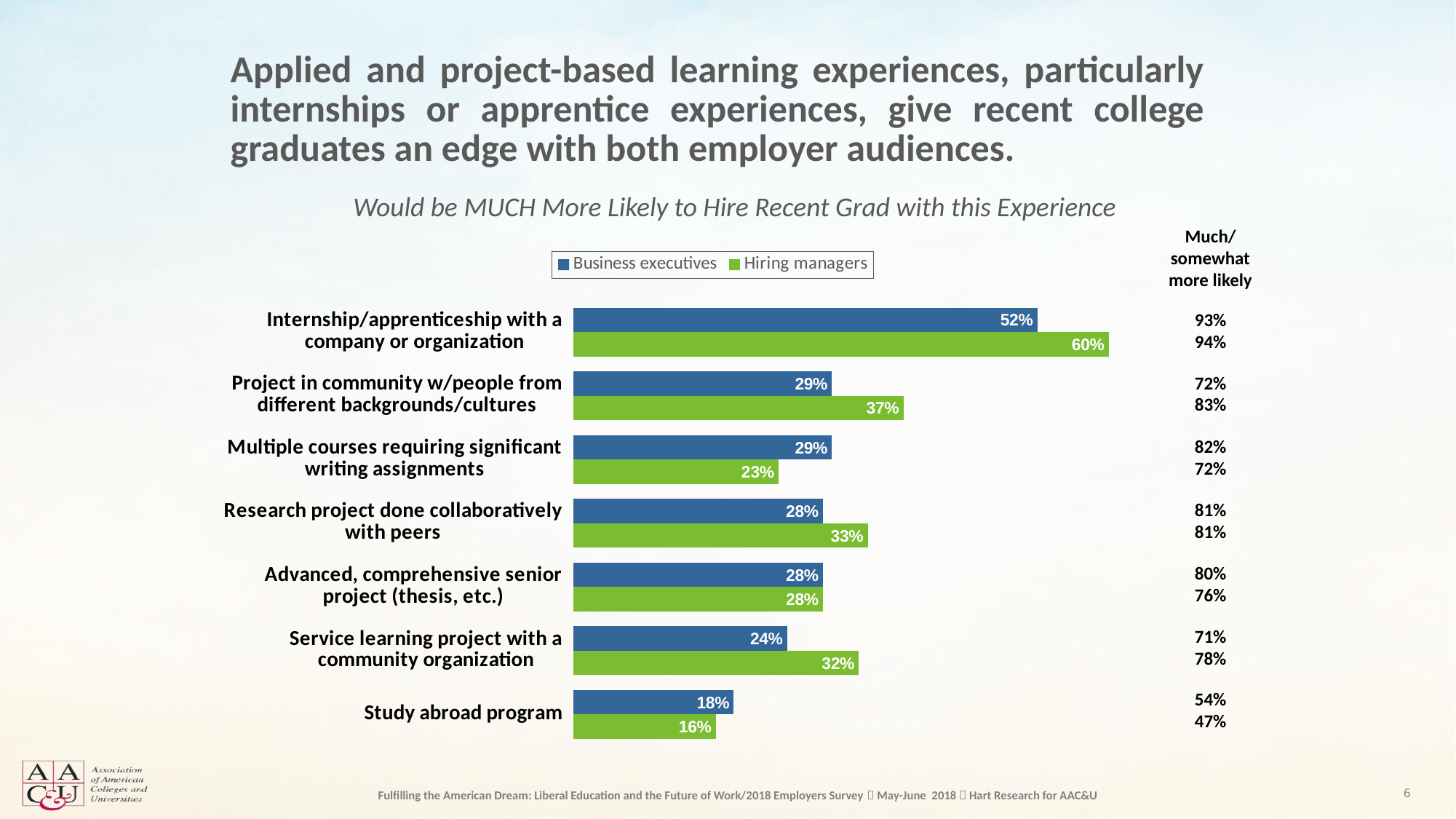
What is the Business executives value for Service learning project with a community organization? 24% Which experience has the highest value for Hiring managers? Internship/apprenticeship with a company or organization How many experience categories are shown in the chart? 7 What is the Hiring managers value for Project in community w/people from different backgrounds/cultures? 37% What percentage of Hiring managers would be much more likely to hire a recent grad with an Internship/apprenticeship with a company or organization? 60% What percentage of Business executives would be much more likely to hire a recent grad with a Study abroad program? 18% What kind of chart is shown on the slide? Bar chart For Multiple courses requiring significant writing assignments, which series has the larger value, Business executives or Hiring managers? Business executives Which experience has the lowest value for Business executives? Study abroad program What is the difference between the Hiring managers and Business executives values for Internship/apprenticeship with a company or organization? 8% How many series does the legend list? 2 Which colour represents Hiring managers in the chart? Green